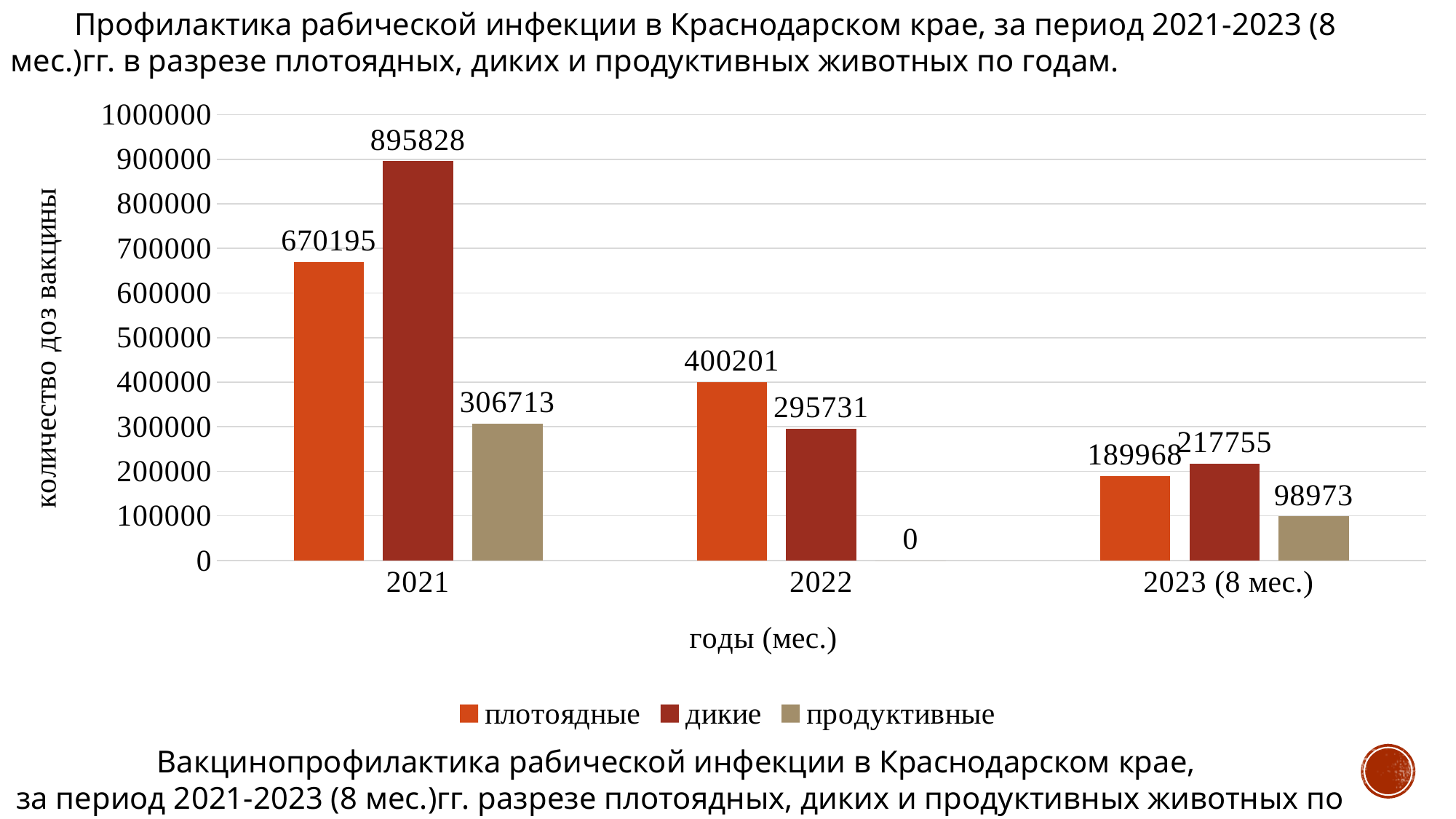
What is the value for продуктивные in 2023 (8 мес.)? 98973 What is the value for плотоядные in 2021? 670195 Which year has the lowest value for плотоядные? 2023 (8 мес.) What is the value for продуктивные in 2022? 0 Is the value for дикие in 2023 (8 мес.) greater or less than 200000? greater What kind of chart is shown on the slide? bar chart What is the value for дикие in 2022? 295731 Which series has the highest value in 2021? дикие Do the values for плотоядные rise or fall from 2021 to 2023 (8 мес.)? fall What is the difference between дикие and плотоядные in 2021? 225633 Which is larger in 2022: плотоядные or дикие? плотоядные How many series does the legend list? 3